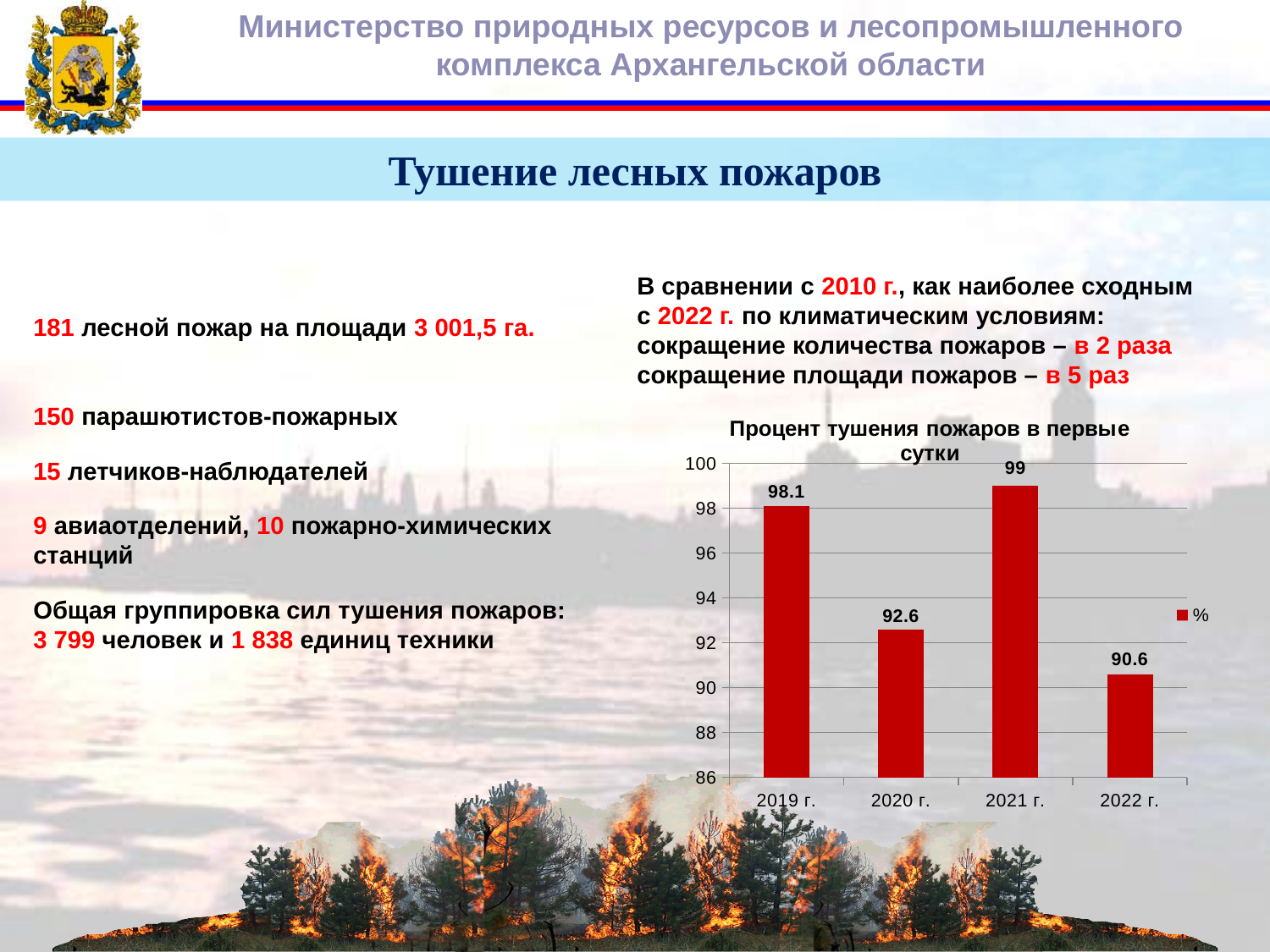
Which year has the highest value in the chart? 2021 г. How many years are shown on the x axis of the chart? 4 What is the legend entry shown for the series in the chart? % What is the value for 2022 г. in the chart? 90.6 What is the value for 2021 г. in the chart? 99 What is the difference between the values for 2021 г. and 2022 г.? 8.4 Which year has the lowest value in the chart? 2022 г. What is the value for 2019 г. in the chart 'Процент тушения пожаров в первые сутки'? 98.1 Which is larger, the value for 2019 г. or the value for 2020 г.? 2019 г. Is the value for 2020 г. greater or less than 94? less What is the value for 2020 г. in the chart? 92.6 What kind of chart is shown on the slide? bar chart